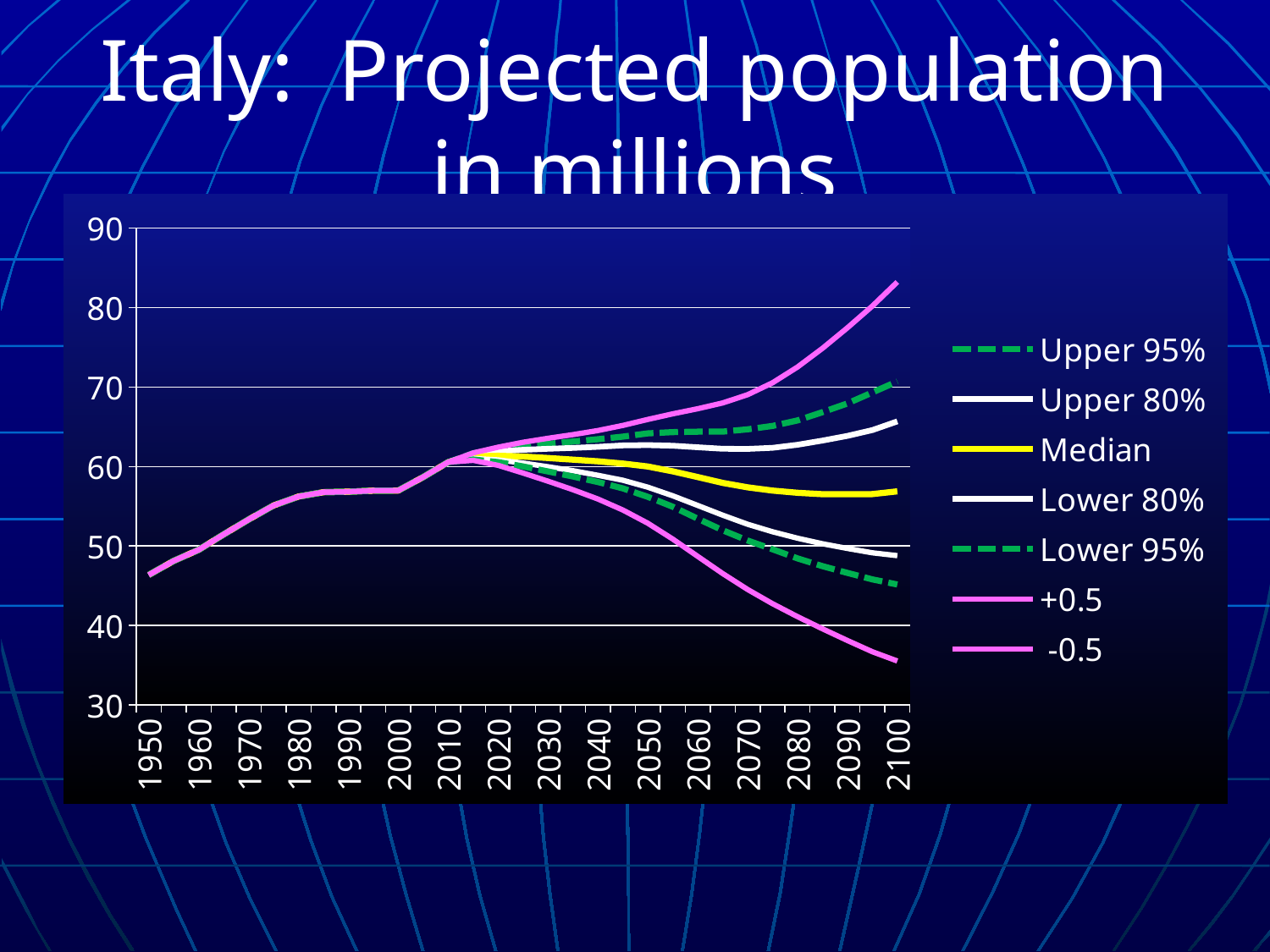
Is the value for the Median series in 2100 greater or less than 60? less Which series has the lowest value in 2100? -0.5 In 2100, which is larger: the Upper 80% series or the Median series? Upper 80% Is the value for the -0.5 series in 2100 greater or less than 40? less What is the title of the chart on the slide? Italy: Projected population in millions Does the Median series rise or fall between 2010 and 2100? fall How many year labels are shown along the x axis? 16 Which series has the highest value in 2100? +0.5 Is the value for the +0.5 series in 2100 greater or less than 80? greater How many series does the legend list? 7 What kind of chart is shown on the slide? line chart